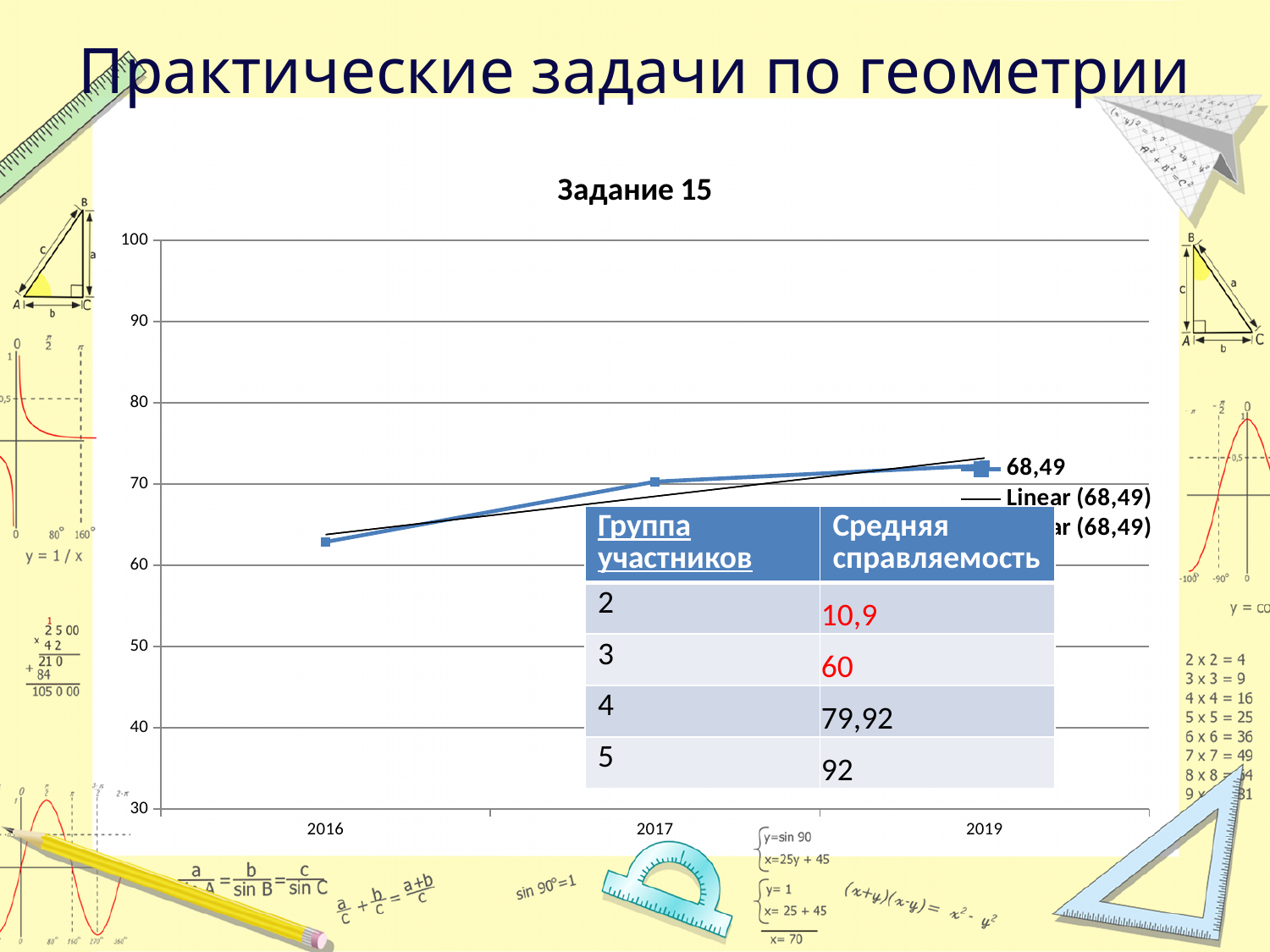
Which year has the lowest plotted value? 2016 What kind of chart is shown under the title "Задание 15"? line chart Is the value for 2019 greater or less than 60? greater Is the value for 2019 greater or less than 80? less Is the value for 2016 greater or less than 60? greater What is the title of the chart? Задание 15 Which is larger, the value for 2017 or the value for 2016? 2017 Do the plotted values rise or fall from 2016 to 2019? rise How many data points are plotted on the line? 3 What is the name of the data series shown with square markers in the legend? 68,49